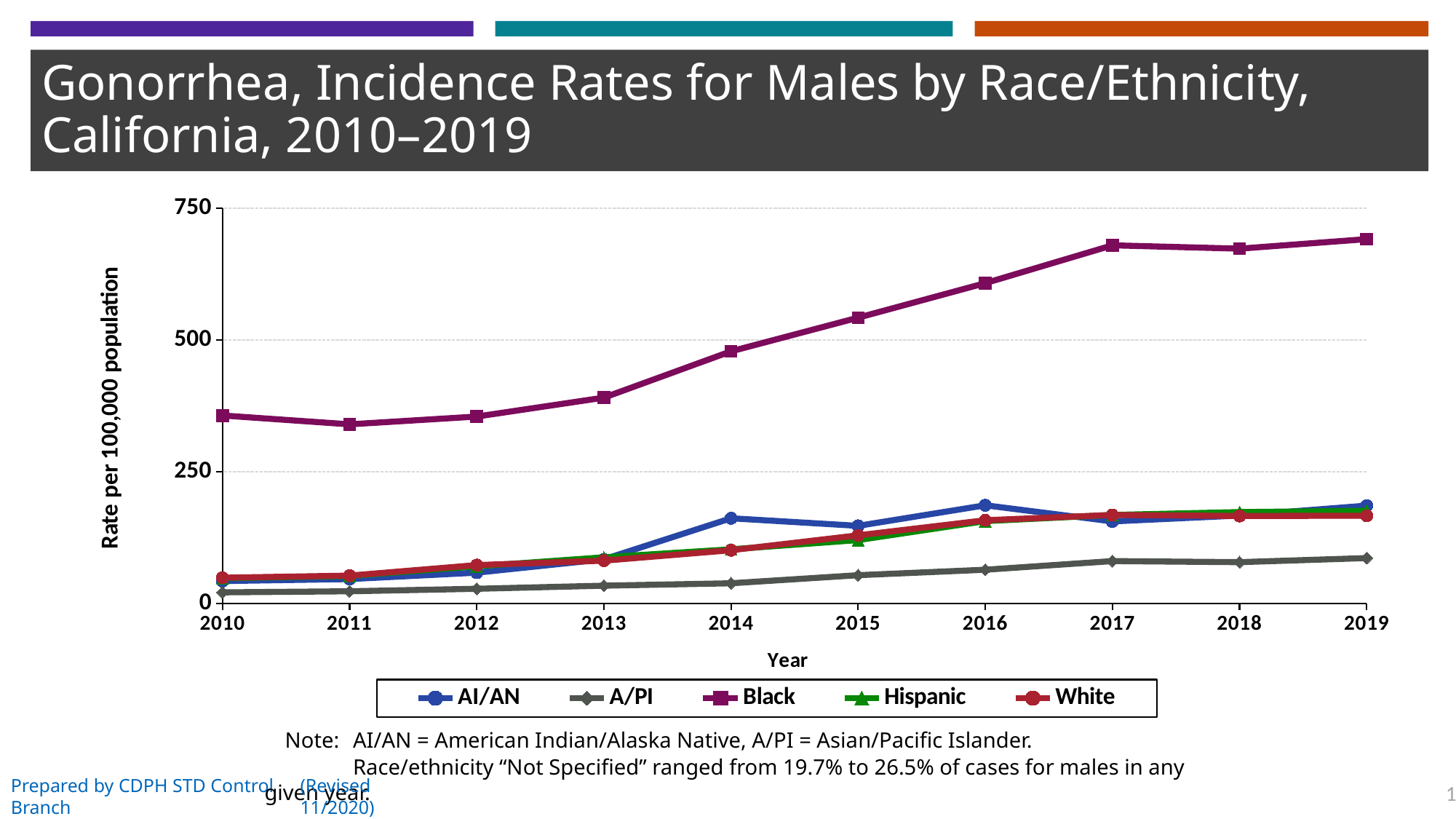
How many years are plotted along the x axis? 10 Which is larger in 2015, the rate for Black males or the rate for White males? Black Is the rate for A/PI males in 2019 greater or less than 250? less What type of chart is shown on the slide? line chart Is the rate for Black males in 2013 greater or less than 500? less Is the rate for Black males in 2019 greater or less than 500? greater What is the label of the y axis? Rate per 100,000 population Which race/ethnicity group has the highest gonorrhea incidence rate for males in 2019? Black How many series does the legend list? 5 Does the rate for Black males generally rise or fall from 2010 to 2019? rise Which race/ethnicity group has the lowest gonorrhea incidence rate for males in 2019? A/PI